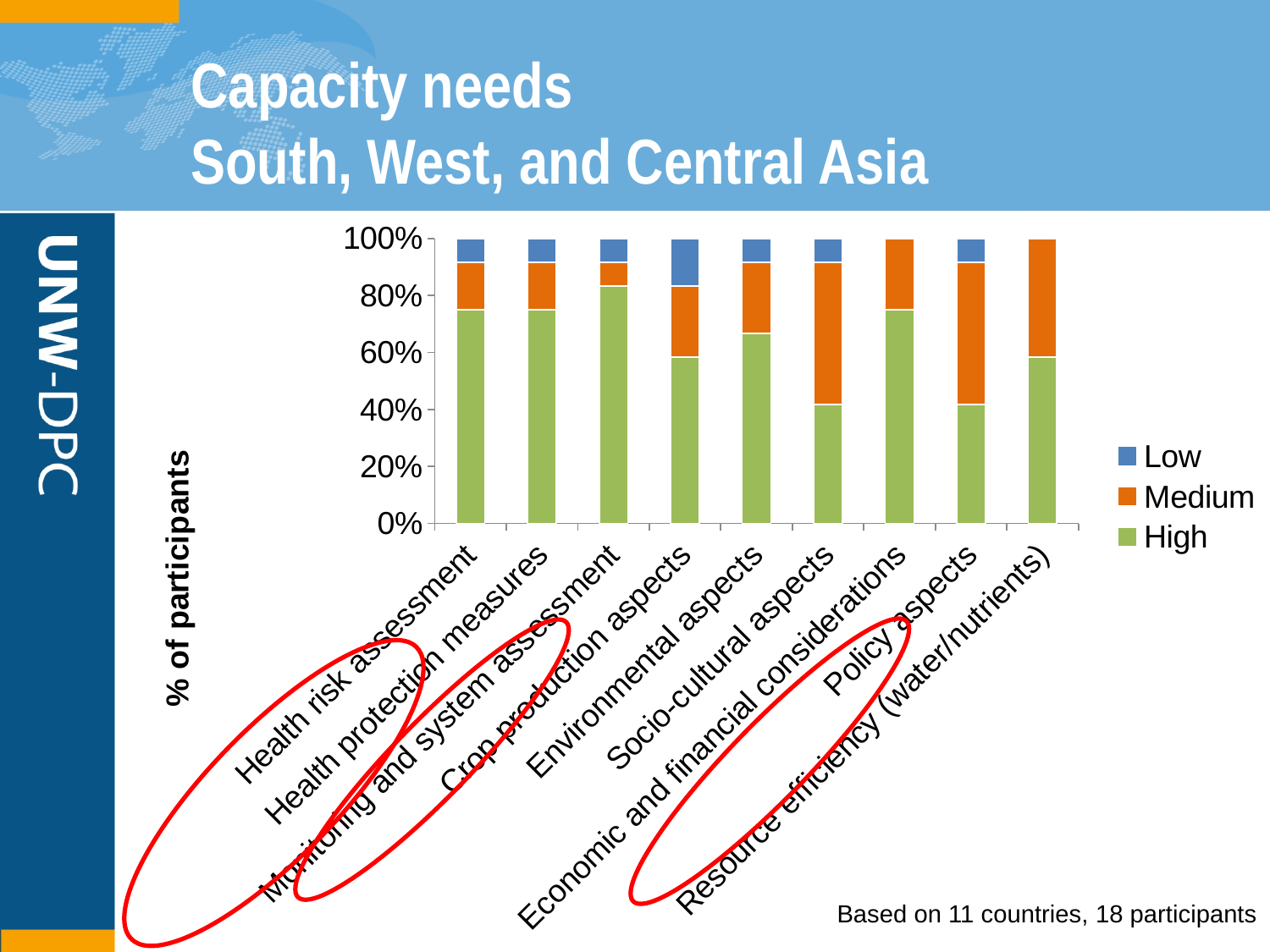
Is the High value for Policy aspects greater or less than 60%? less Is the High value for Economic and financial considerations greater or less than 60%? greater How many series does the legend list? 3 Is the High value for Monitoring and system assessment greater or less than 60%? greater How many categories are plotted along the x axis? 9 What is the title of the slide containing the chart? Capacity needs South, West, and Central Asia Which category has the largest Low segment? Crop production aspects Which category has the largest High segment? Monitoring and system assessment What label is shown on the vertical axis of the chart? % of participants What kind of chart is shown on the slide? stacked bar chart Which has a larger High segment, Monitoring and system assessment or Economic and financial considerations? Monitoring and system assessment